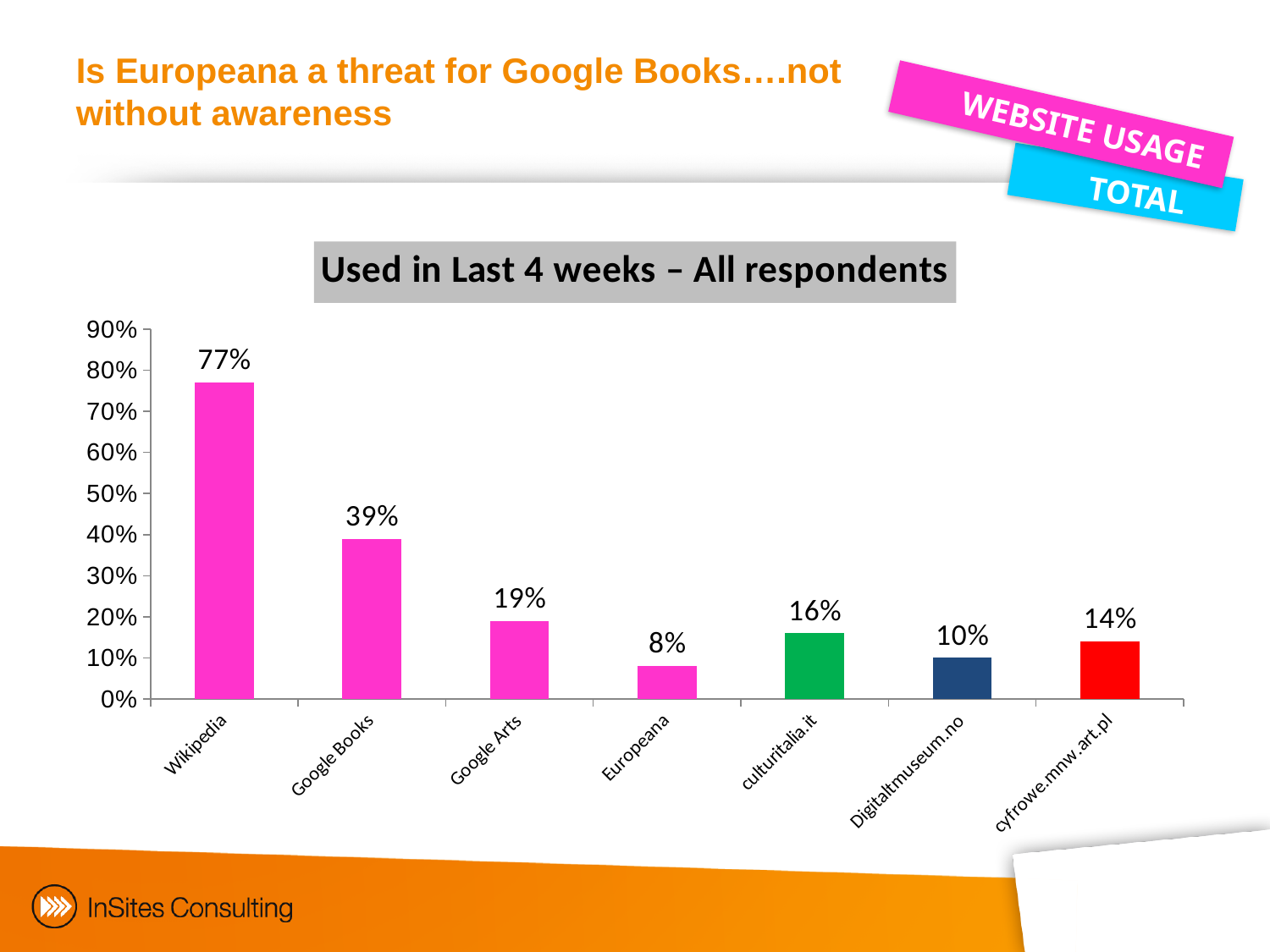
What is the value shown for Google Books? 39% What is the value shown for Digitaltmuseum.no? 10% Which website has the lowest usage in the last 4 weeks? Europeana What kind of chart is shown on the slide? Bar chart What is the difference between the values for Wikipedia and Google Books? 38% How many websites are shown on the chart? 7 What percentage of respondents used Wikipedia in the last 4 weeks? 77% Which has a higher value, culturitalia.it or cyfrowe.mnw.art.pl? culturitalia.it Which website has the highest usage in the last 4 weeks? Wikipedia What is the title of the chart? Used in Last 4 weeks – All respondents What is the value shown for Europeana? 8% What is the difference between the values for Google Arts and Europeana? 11%